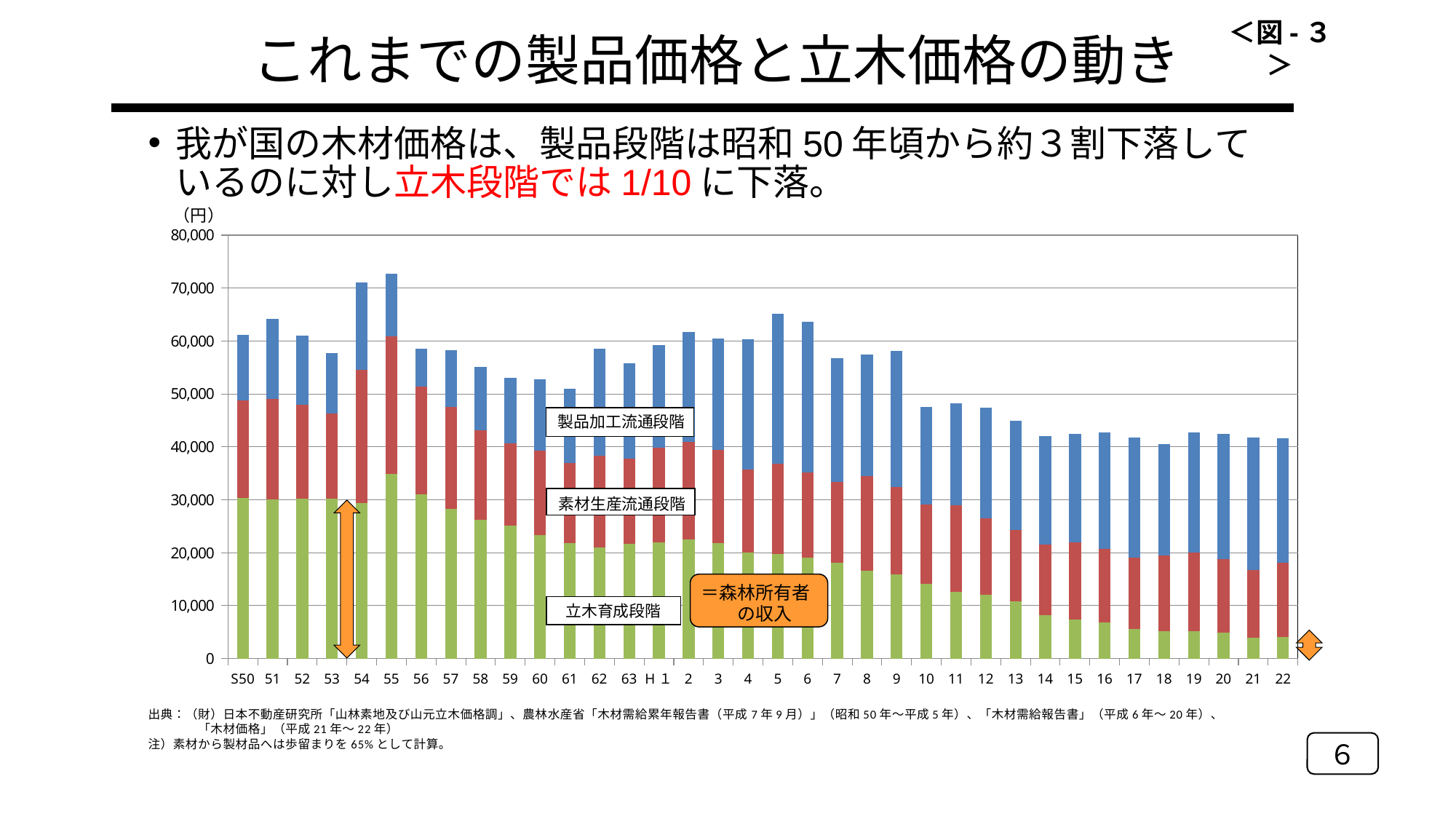
Which year has the tallest total bar in the chart? 55 Does the 立木育成段階 (green) segment generally rise or fall from S50 to 22? fall How many stacked segments (series) make up each bar in the chart? 3 Which has the taller total bar, 53 or 54? 54 How many year categories are shown along the x axis of the chart? 36 Is the 立木育成段階 (green) segment for 22 greater or less than 10,000? less What unit is shown at the top of the y axis of the chart? （円） What kind of chart is shown on the slide? stacked bar chart Is the total bar for 22 greater or less than 50,000? less Which year has the largest 立木育成段階 (green) segment? 55 Is the total bar for H5 greater or less than 60,000? greater